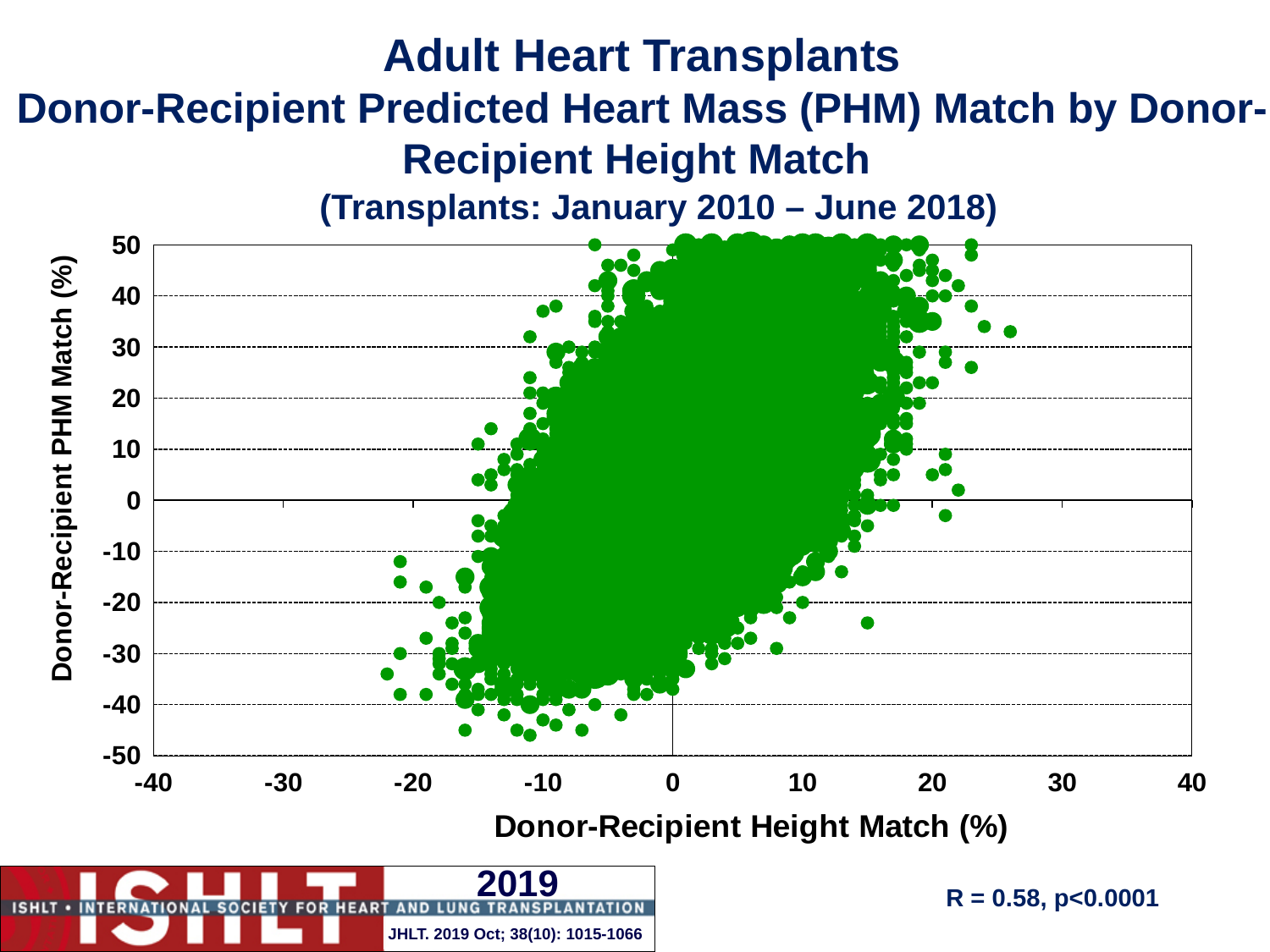
What colour are the data points in the scatter plot? Green What is the label of the x axis? Donor-Recipient Height Match (%) What is the correlation coefficient R reported on the slide? R = 0.58 What kind of chart is shown on the slide? Scatter plot What p-value is reported on the slide for the relationship shown? p<0.0001 As Donor-Recipient Height Match (%) increases along the x axis, does Donor-Recipient PHM Match (%) tend to rise or fall? Rise